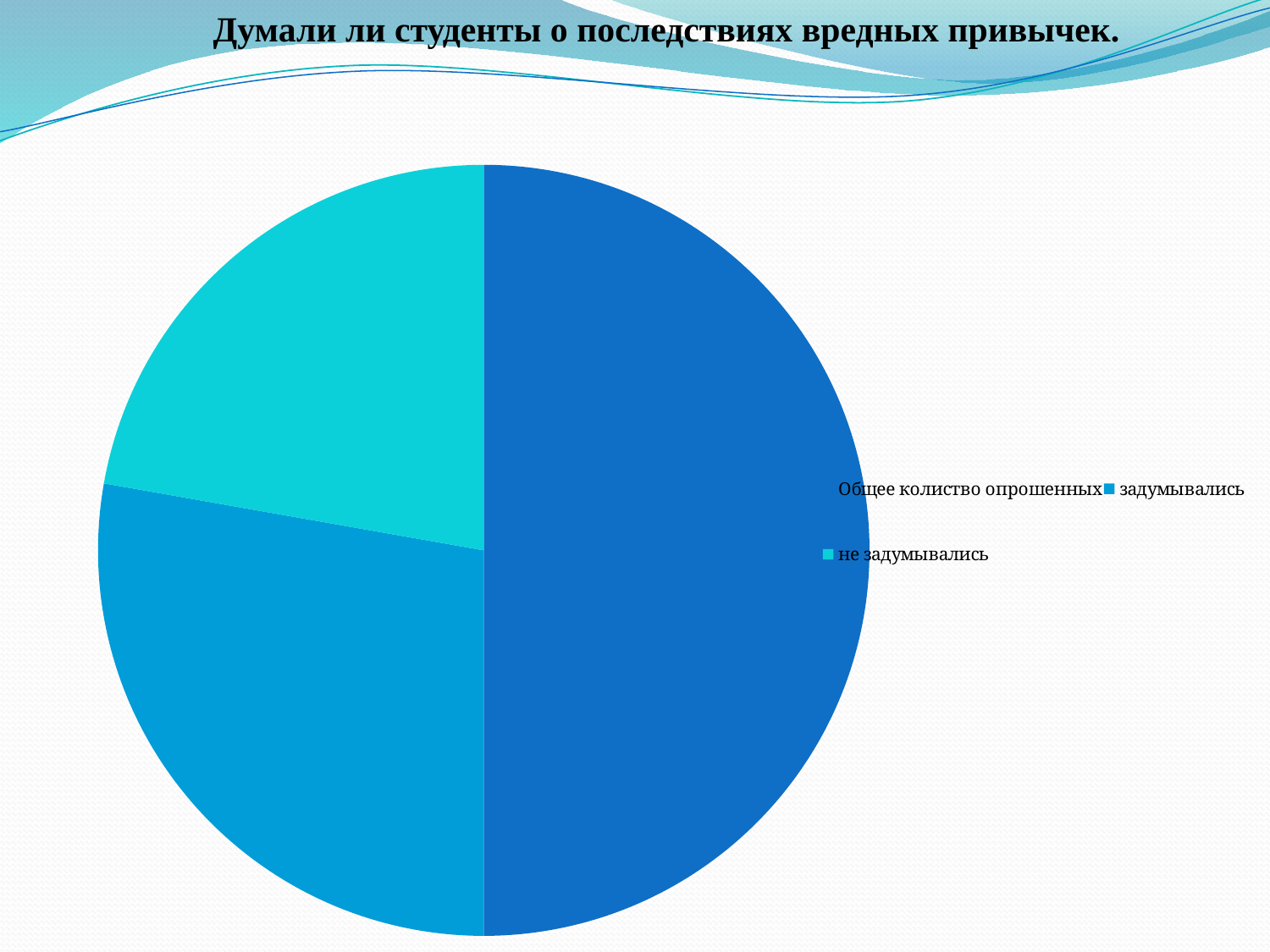
Which slice of the pie chart is the smallest? не задумывались Which slice of the pie chart is the largest? Общее колиство опрошенных Which slice is larger: Общее колиство опрошенных or задумывались? Общее колиство опрошенных Which legend entry is shown in the lightest (cyan) colour? не задумывались What is the title of the slide containing the pie chart? Думали ли студенты о последствиях вредных привычек. How many entries does the legend of the pie chart list? 3 Which slice is larger: задумывались or не задумывались? задумывались How many slices does the pie chart have? 3 What kind of chart is shown on the slide? pie chart